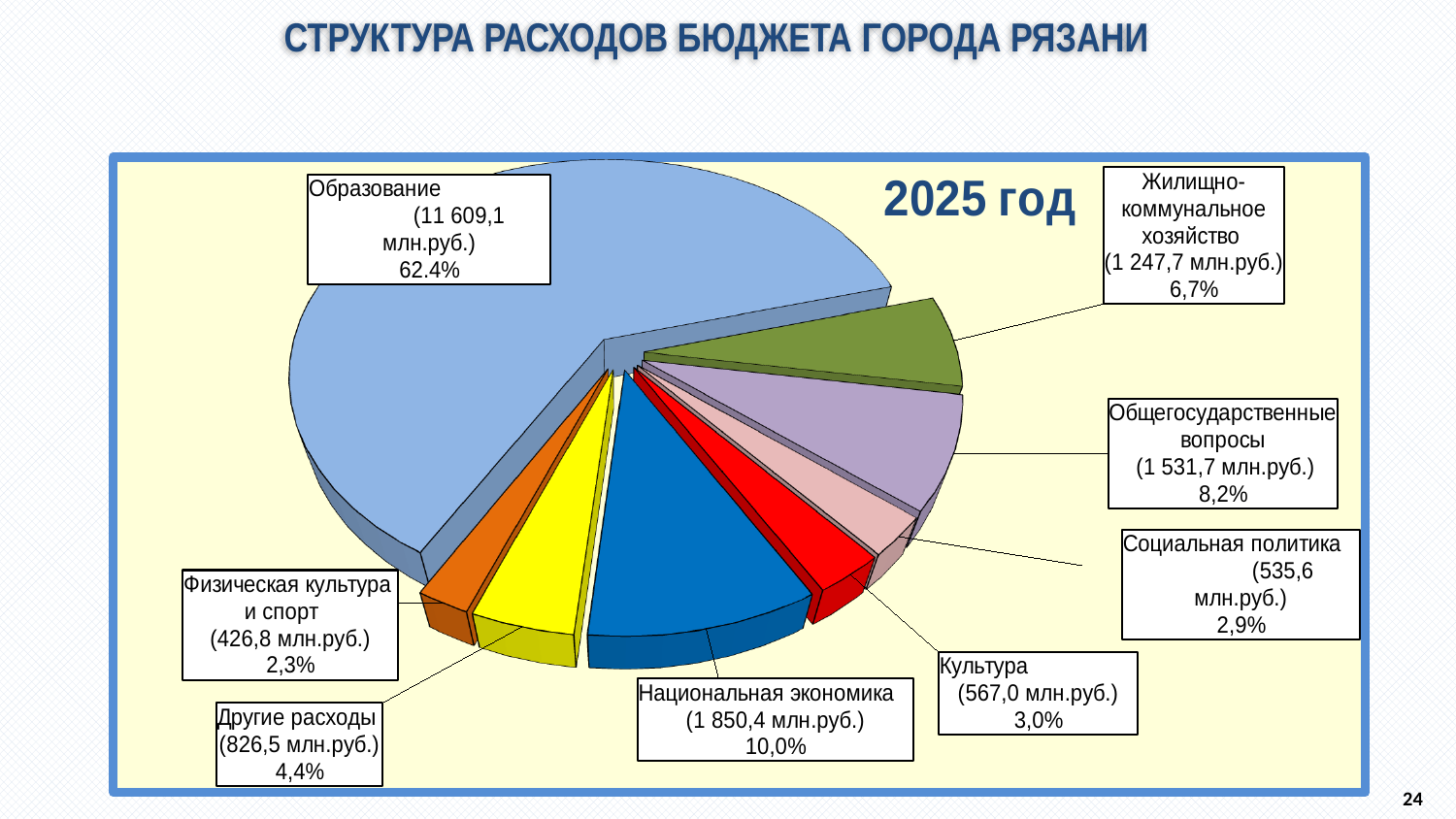
How many categories (slices) does the pie chart show? 8 Which category has the smallest share of the pie? Физическая культура и спорт What kind of chart is shown on the slide? Pie chart Which is larger: Культура or Социальная политика? Культура What is the value for Другие расходы in млн.руб.? 826,5 млн.руб. What is the difference in млн.руб. between Национальная экономика and Общегосударственные вопросы? 318,7 млн.руб. What is the value for Жилищно-коммунальное хозяйство in млн.руб.? 1 247,7 млн.руб. Which year is the pie chart labelled with? 2025 год What percentage share is shown for Общегосударственные вопросы? 8,2% What is the value for Образование in млн.руб.? 11 609,1 млн.руб. What share of the pie does Национальная экономика have? 10,0% Which category has the largest share of the pie? Образование